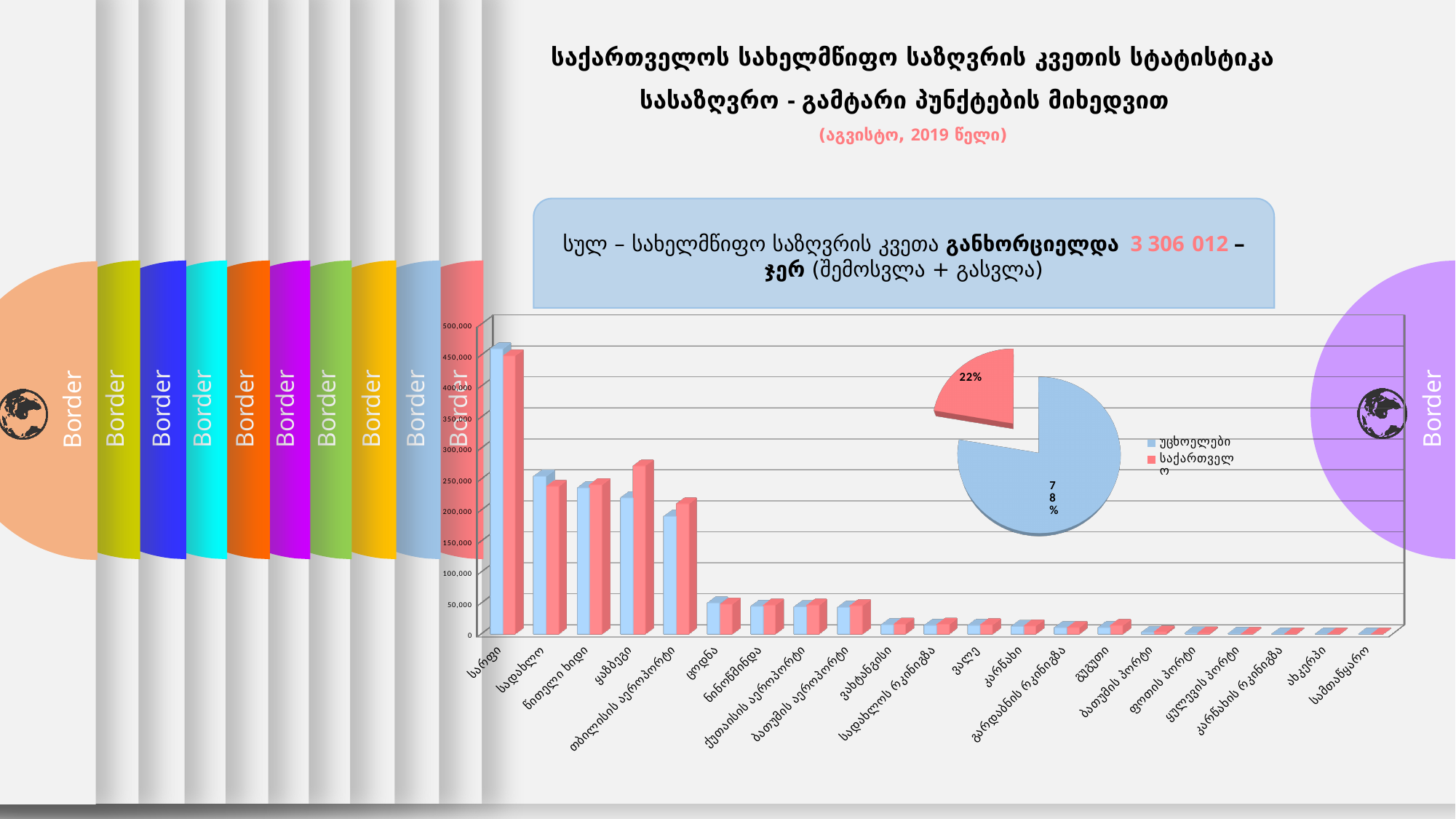
In the pie chart, which slice is larger, უცხოელები or საქართველო? უცხოელები In the pie chart, what share is shown for the უცხოელები slice? 78% In the bar chart, do the values generally rise or fall from left to right along the category axis? fall In the pie chart, what is the difference between the უცხოელები share and the საქართველო share? 56% How many series does the legend list? 2 In the bar chart, which category has the highest bars? სარფი In the pie chart, what share is shown for the საქართველო slice? 22% What kind of chart is the chart on the left side of the slide (with the category axis)? bar chart What kind of chart is the smaller chart on the right showing 22% and 78%? pie chart